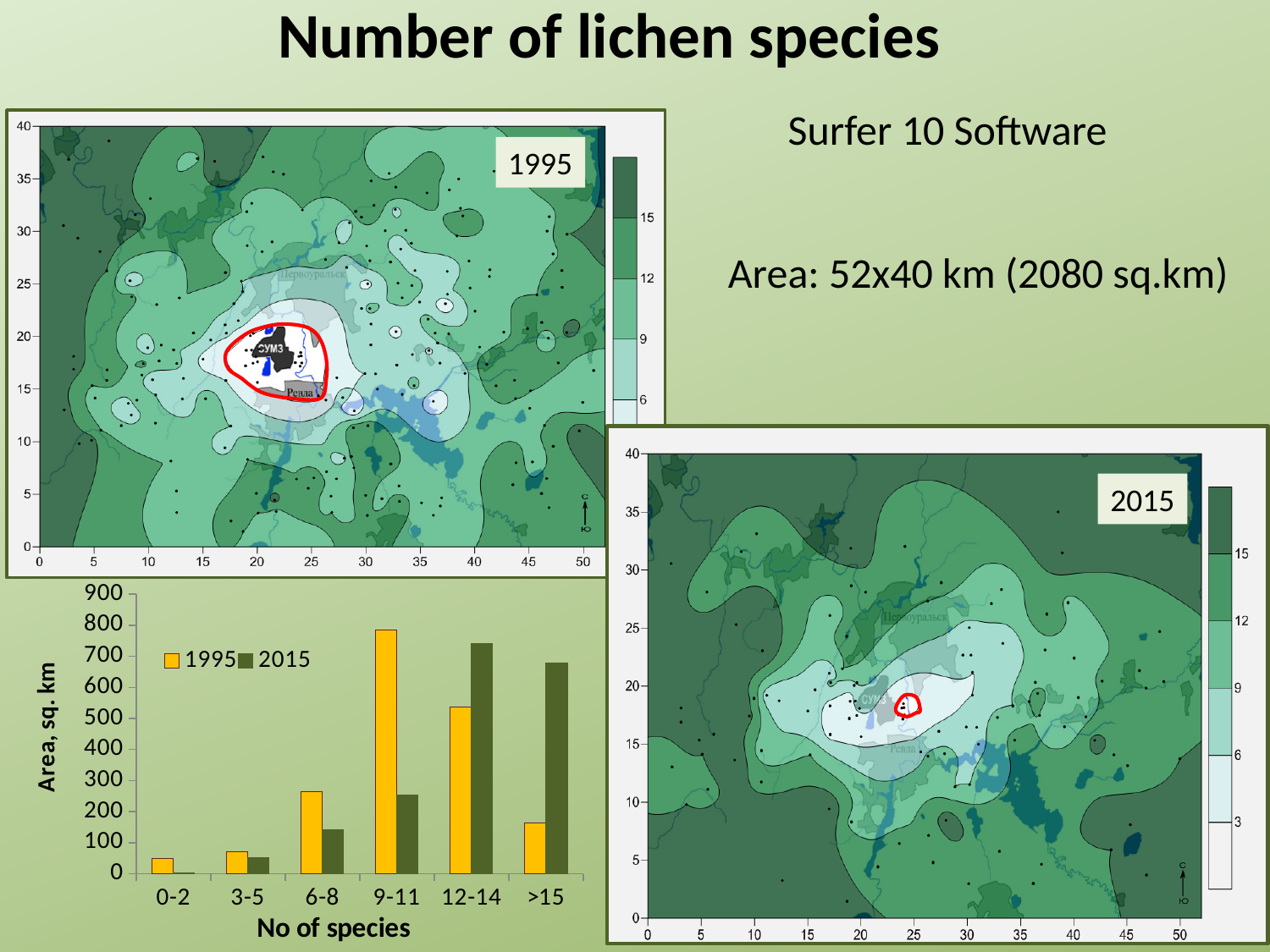
What kind of chart is the bar chart at the bottom left of the slide? bar chart In the bar chart, which category has the lowest value for the 1995 series? 0-2 In the bar chart, is the 2015 value for the 6-8 category greater or less than 200? less In the bar chart, which category has the highest value for the 1995 series? 9-11 In the bar chart, for the >15 category, which series has the larger value, 1995 or 2015? 2015 In the bar chart, how many categories are shown on the x axis? 6 In the bar chart, what is the title of the y axis? Area, sq. km In the bar chart, for the 9-11 category, which series has the larger value, 1995 or 2015? 1995 In the bar chart, which category has the highest value for the 2015 series? 12-14 In the bar chart, is the 1995 value for the 9-11 category greater or less than 700? greater In the bar chart, which category has the lowest value for the 2015 series? 0-2 In the bar chart, how many series does the legend list? 2